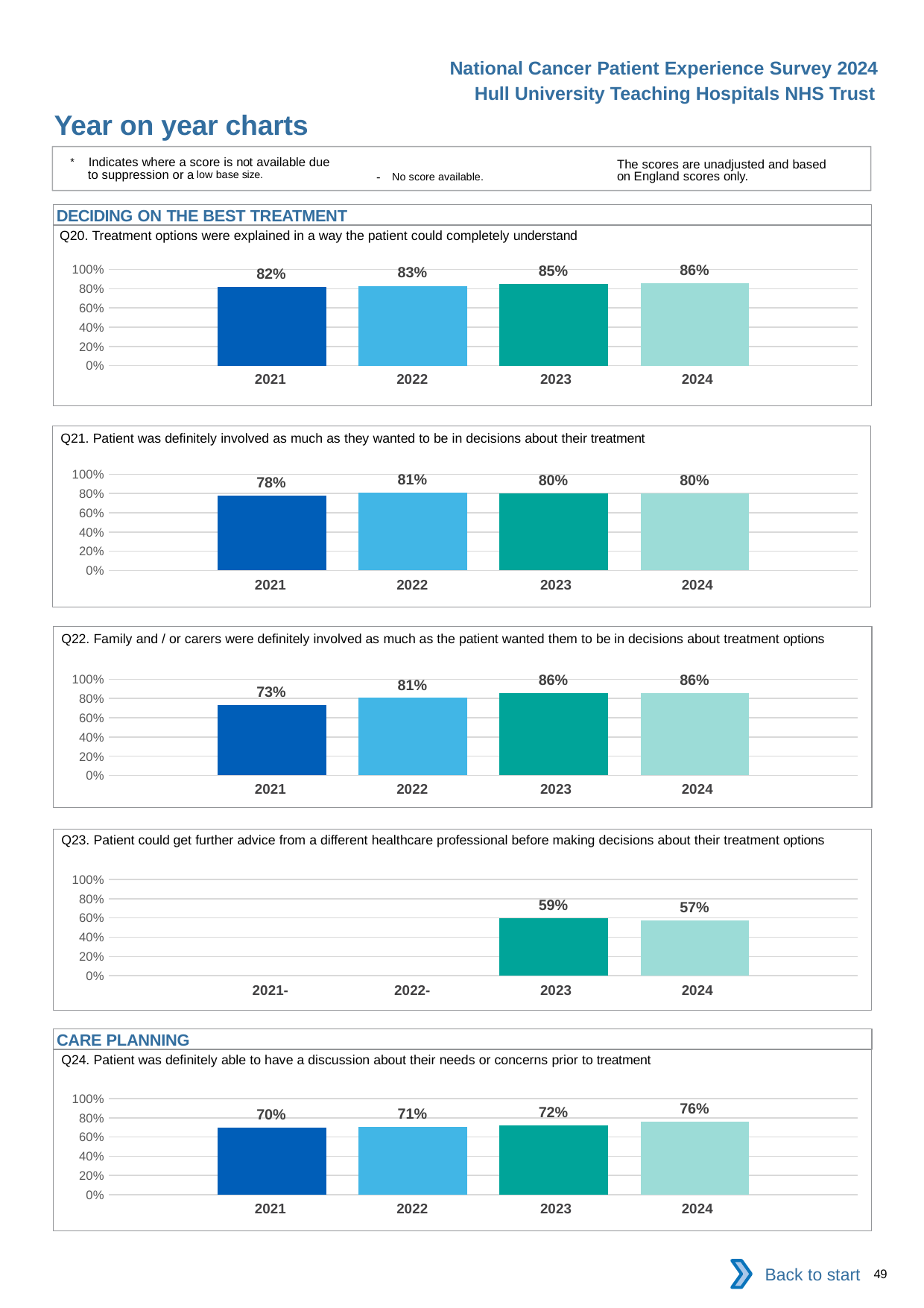
In the Q24 chart, what is the value for 2022? 71% In the Q23 chart, how many years have a bar plotted? 2 In the Q21 chart, which year has the lowest value? 2021 In the Q24 chart, which year has the highest value? 2024 In the Q23 chart, which is larger, the value for 2023 or the value for 2024? 2023 In the Q22 chart, what is the difference between the 2024 value and the 2021 value? 13% In the Q20 chart, do the values rise or fall from 2021 to 2024? rise What kind of chart is used for Q24? bar chart In the Q21 chart, what is the difference between the 2022 value and the 2021 value? 3% In the Q20 chart, what is the value for 2024? 86% In the Q23 chart, is the value for 2024 greater or less than 60%? less In the Q22 chart, what is the value for 2021? 73%